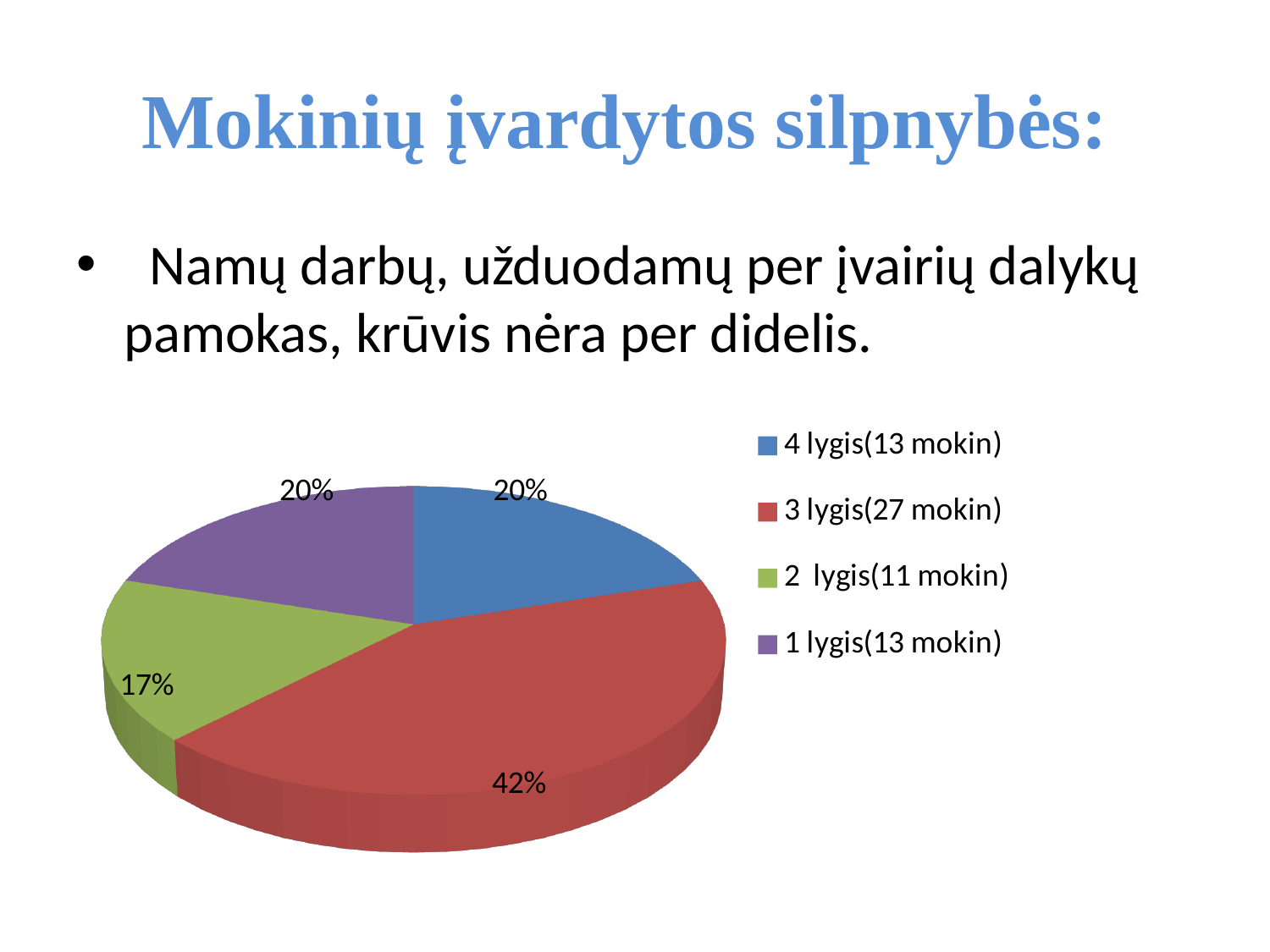
What share of the pie does the slice for 2 lygis(11 mokin) represent? 17% What share of the pie does the slice for 1 lygis(13 mokin) represent? 20% What share of the pie does the slice for 3 lygis(27 mokin) represent? 42% What is the difference in percentage points between the slices for 3 lygis(27 mokin) and 2 lygis(11 mokin)? 25 Which slice is larger: 3 lygis(27 mokin) or 4 lygis(13 mokin)? 3 lygis(27 mokin) How many entries does the legend list? 4 How many slices does the pie chart have? 4 Which category has the smallest slice of the pie? 2 lygis(11 mokin) Which category has the largest slice of the pie? 3 lygis(27 mokin) What kind of chart is shown on the slide? pie chart What colour is the slice for 3 lygis(27 mokin)? red